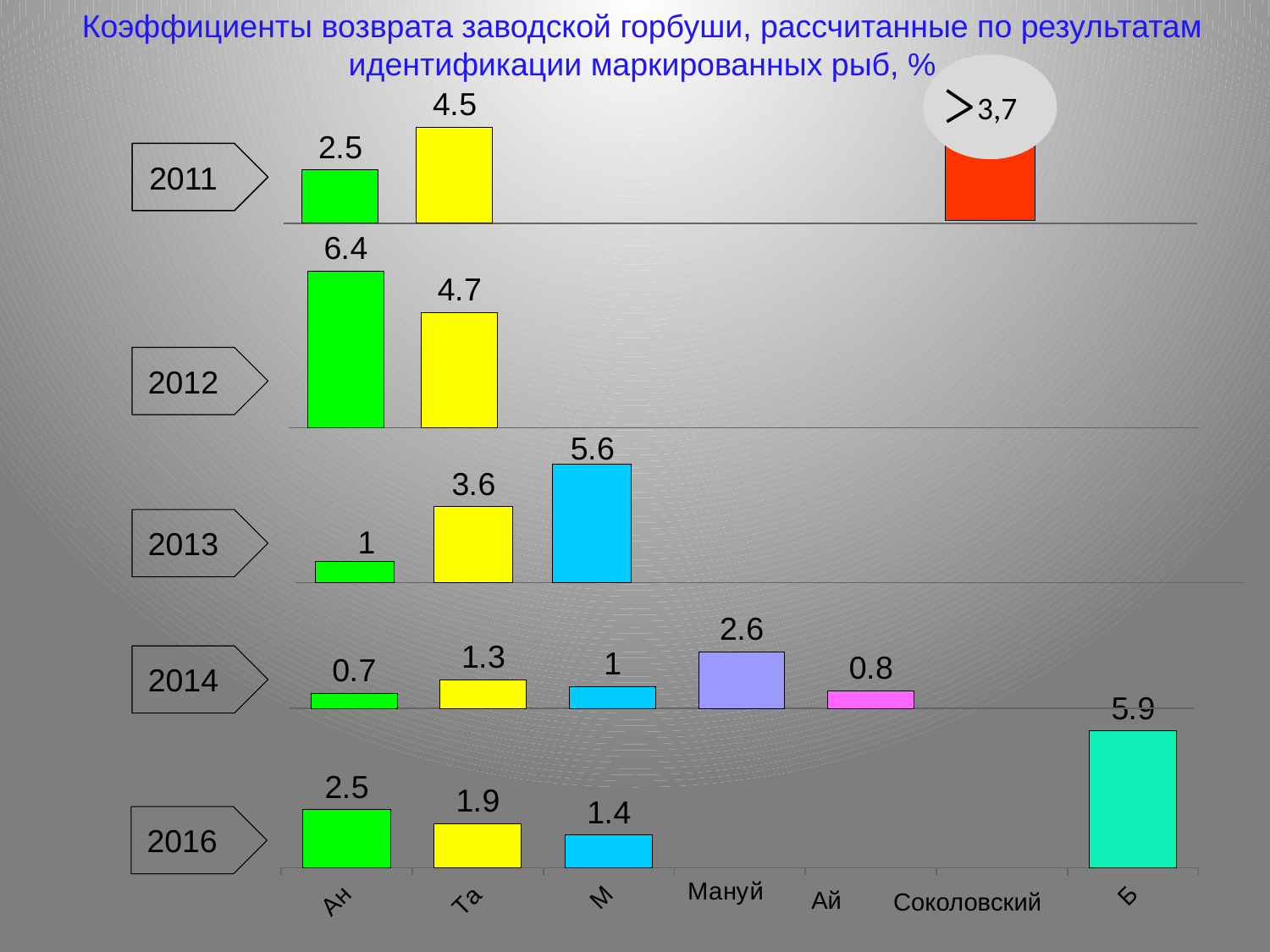
What kind of chart is used on this slide? bar chart In the 2016 chart, which is larger, the value for Ан or the value for Та? Ан In the 2012 chart, what is the difference between the values for Ан and Та? 1.7 In the 2014 chart, which category has the highest value? Мануй In the 2011 chart, what is the value for Та? 4.5 In the 2012 chart, what is the value for Ан? 6.4 In the 2013 chart, which category has the lowest value? Ан In the 2016 chart, what is the difference between the values for Б and М? 4.5 How many bars are shown in the 2014 chart? 5 In the 2014 chart, what is the value for Мануй? 2.6 In the 2016 chart, what is the value for Б? 5.9 In the 2013 chart, what is the value for М? 5.6